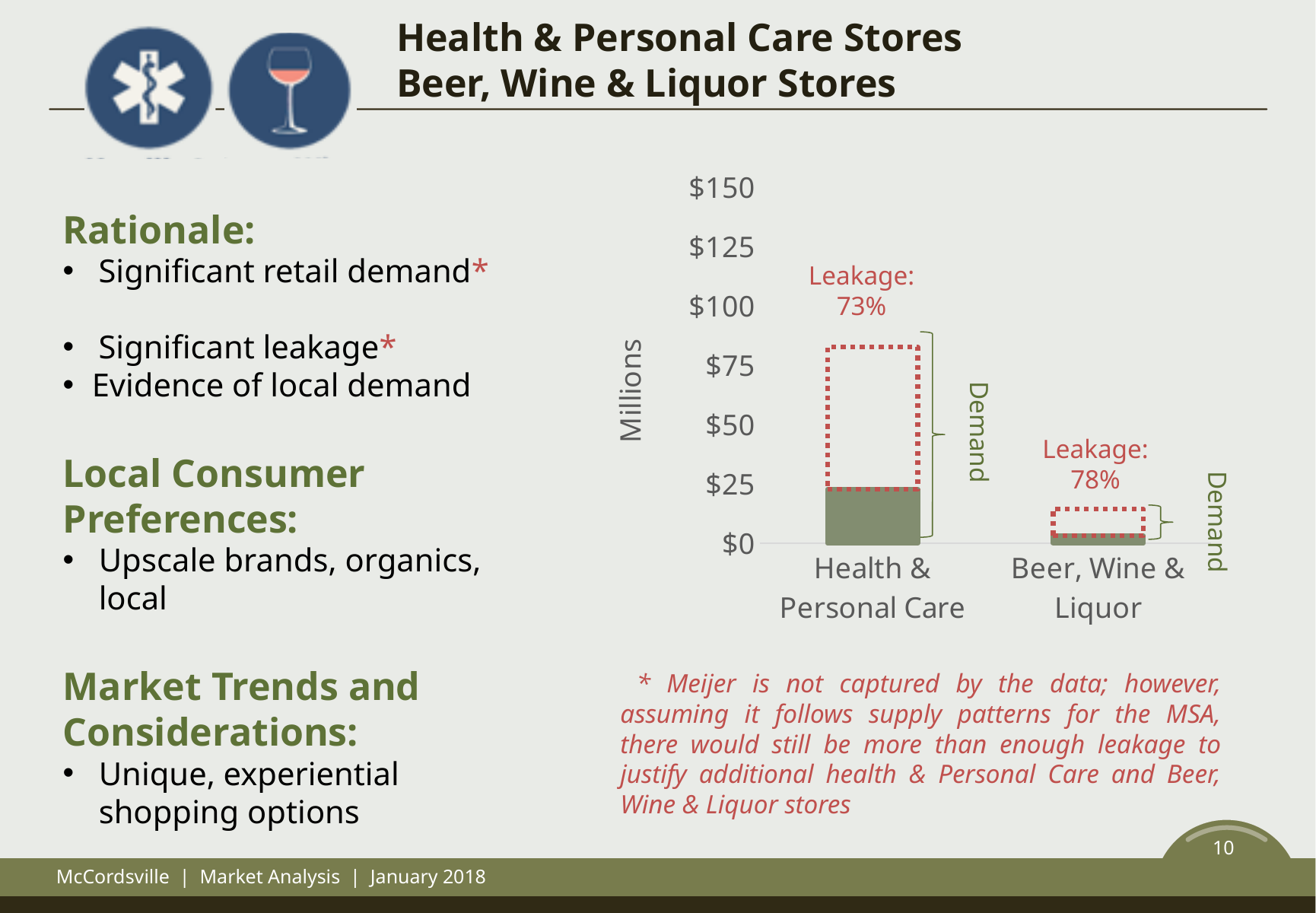
Which category shows greater demand, Health & Personal Care or Beer, Wine & Liquor? Health & Personal Care Is the demand value for Beer, Wine & Liquor greater or less than $25? less How many categories are shown on the x axis of the chart? 2 Which category has the lower leakage percentage? Health & Personal Care What kind of chart is shown on the slide? Bar chart Is the demand value for Health & Personal Care greater or less than $75? greater What leakage percentage is shown for Beer, Wine & Liquor? 78% What is the difference between the leakage percentages of Beer, Wine & Liquor and Health & Personal Care? 5 percentage points What leakage percentage is shown for Health & Personal Care? 73% Is the solid bar for Health & Personal Care greater or less than $50? less What is the label on the vertical axis of the chart? Millions Which category has the higher leakage percentage? Beer, Wine & Liquor